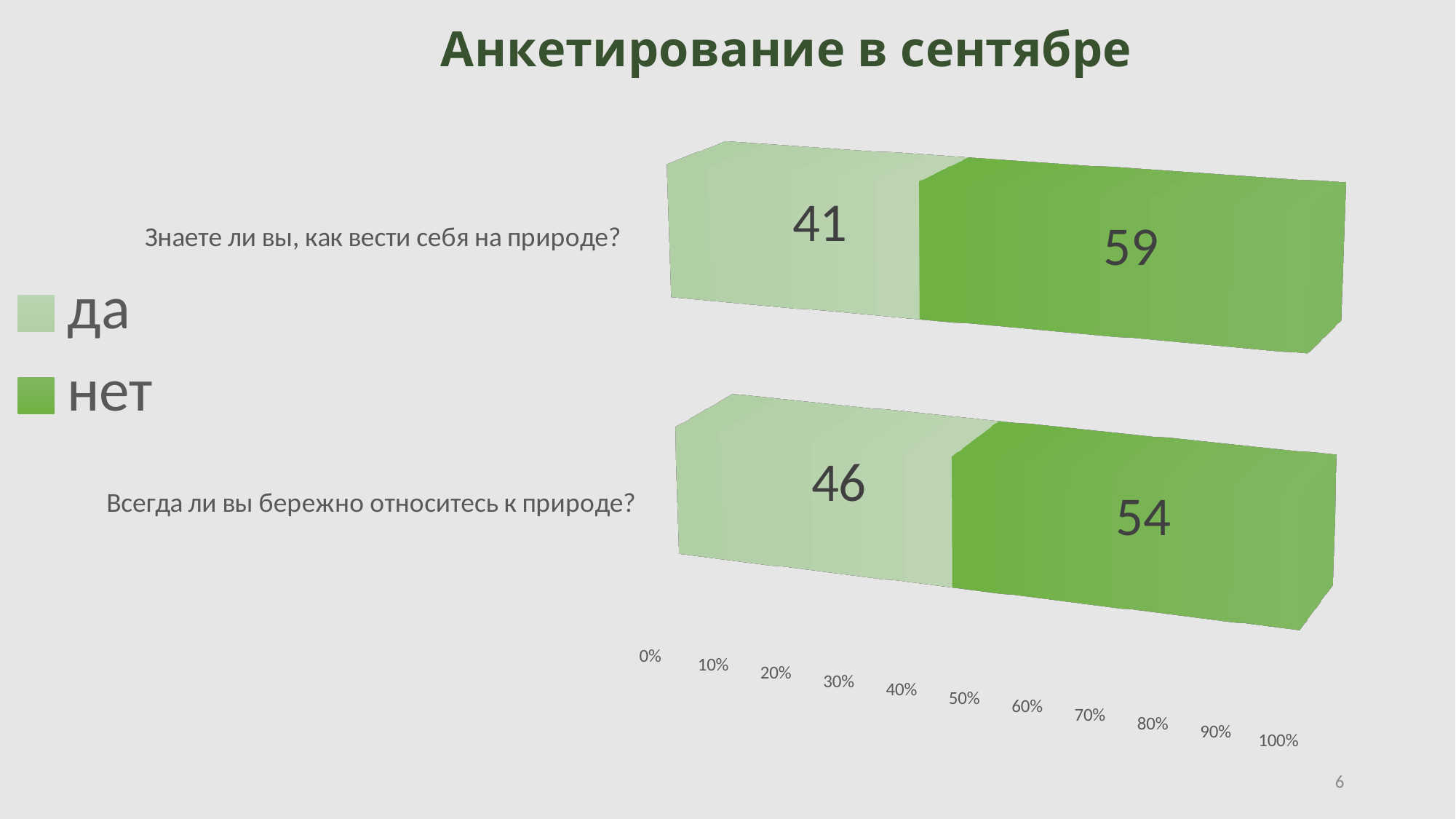
How many questions (categories) are shown in the chart? 2 Which question has the lower value for "да"? Знаете ли вы, как вести себя на природе? What is the value for "нет" for the question "Всегда ли вы бережно относитесь к природе?"? 54 What is the value for "нет" for the question "Знаете ли вы, как вести себя на природе?"? 59 How many series does the legend list? 2 Which question has the higher value for "нет"? Знаете ли вы, как вести себя на природе? For "Всегда ли вы бережно относитесь к природе?", which is larger: "да" or "нет"? нет What is the difference between the "нет" and "да" values for "Всегда ли вы бережно относитесь к природе?"? 8 What is the value for "да" for the question "Знаете ли вы, как вести себя на природе?"? 41 What is the value for "да" for the question "Всегда ли вы бережно относитесь к природе?"? 46 What is the difference between the "нет" and "да" values for "Знаете ли вы, как вести себя на природе?"? 18 What kind of chart is shown on the slide? Stacked bar chart